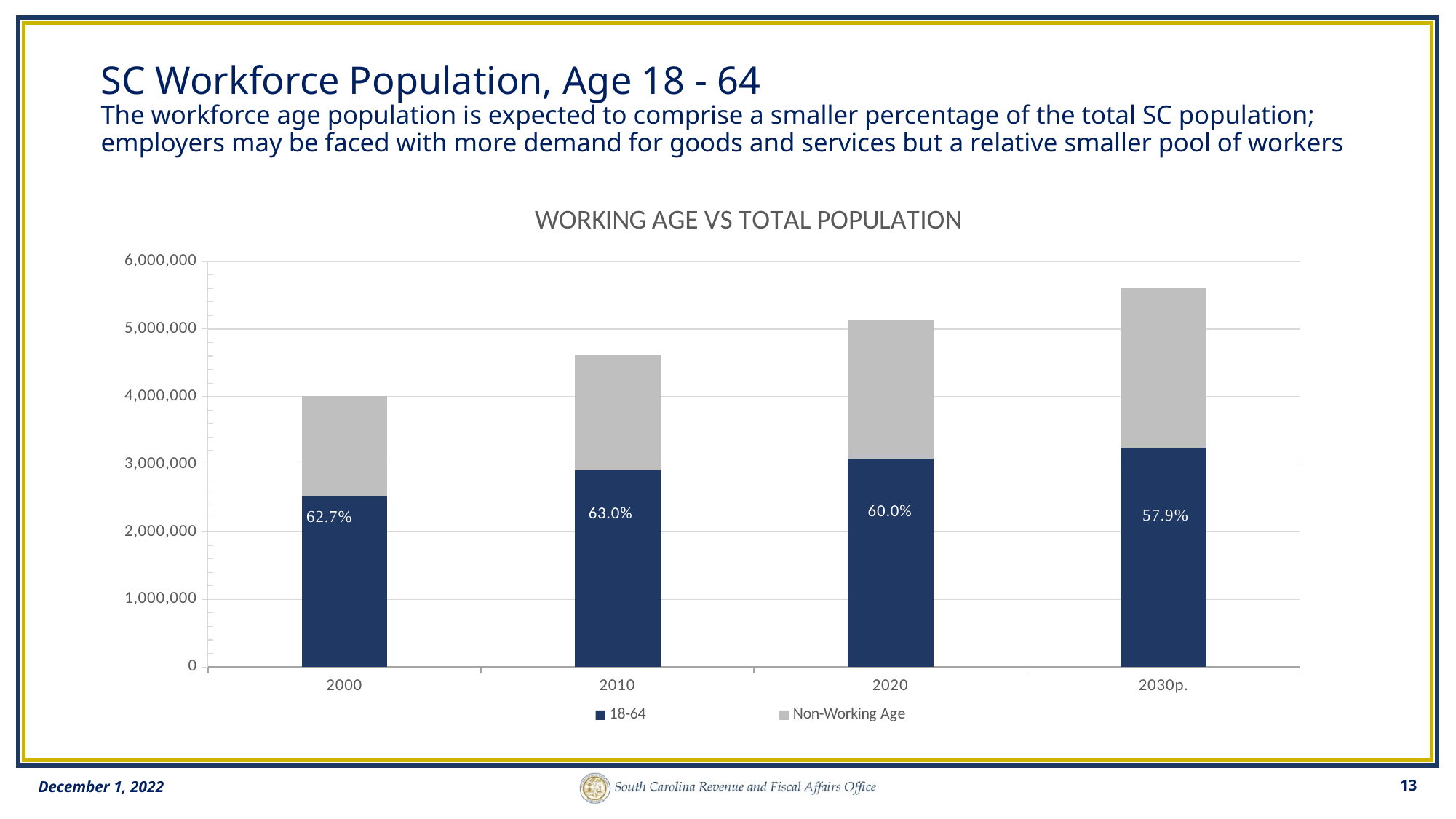
Is the total stacked bar for 2030p. greater or less than 5,000,000? greater How many years are shown on the x axis? 4 What percentage label is shown on the 18-64 segment for 2000? 62.7% Which year has the taller total stacked bar, 2010 or 2020? 2020 Which year has the highest 18-64 percentage label? 2010 What percentage label is shown on the 18-64 segment for 2020? 60.0% Is the 18-64 segment for 2000 greater or less than 2,000,000? greater How many series does the legend list? 2 What is the difference between the 18-64 percentage labels for 2010 and 2030p.? 5.1 percentage points What kind of chart is shown on the slide? Stacked bar chart Which year has the lowest 18-64 percentage label? 2030p. What percentage label is shown on the 18-64 segment for 2030p.? 57.9%